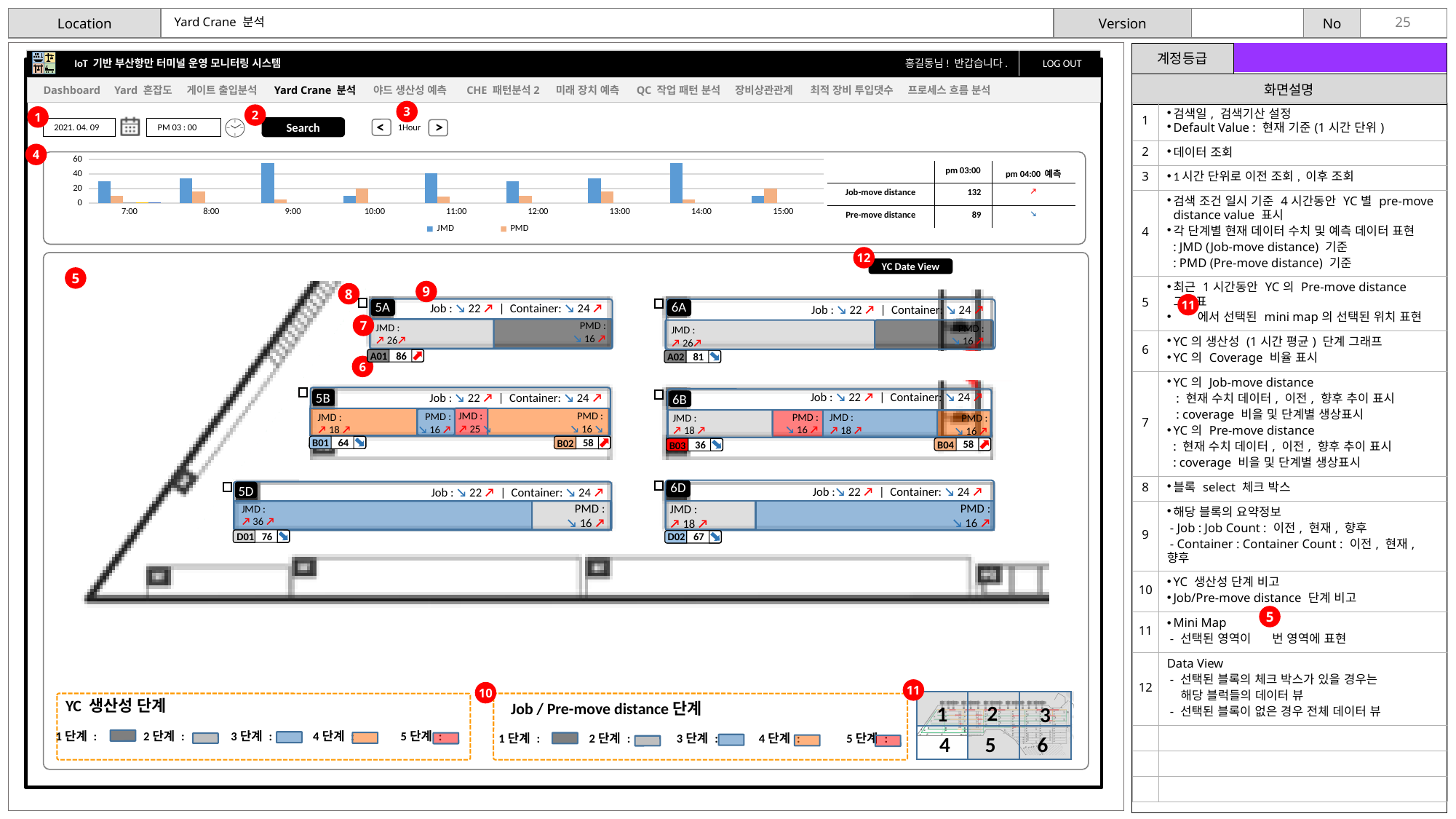
In the top bar chart, which colour represents the JMD series? blue In the top bar chart, is the JMD value at 11:00 greater or less than 20? greater What kind of chart is shown in the top panel of the slide? bar chart In the top bar chart, does the JMD value rise or fall from 14:00 to 15:00? fall In the top bar chart, is the PMD value at 7:00 greater or less than 20? less In the top bar chart, is the JMD value at 9:00 greater or less than 40? greater How many time categories are shown on the x axis of the top bar chart? 9 In the top bar chart, which series has the larger value at 10:00, JMD or PMD? PMD What are the two series named in the legend of the top bar chart? JMD and PMD How many series does the legend of the top bar chart list? 2 In the top bar chart, which series has the larger value at 9:00, JMD or PMD? JMD